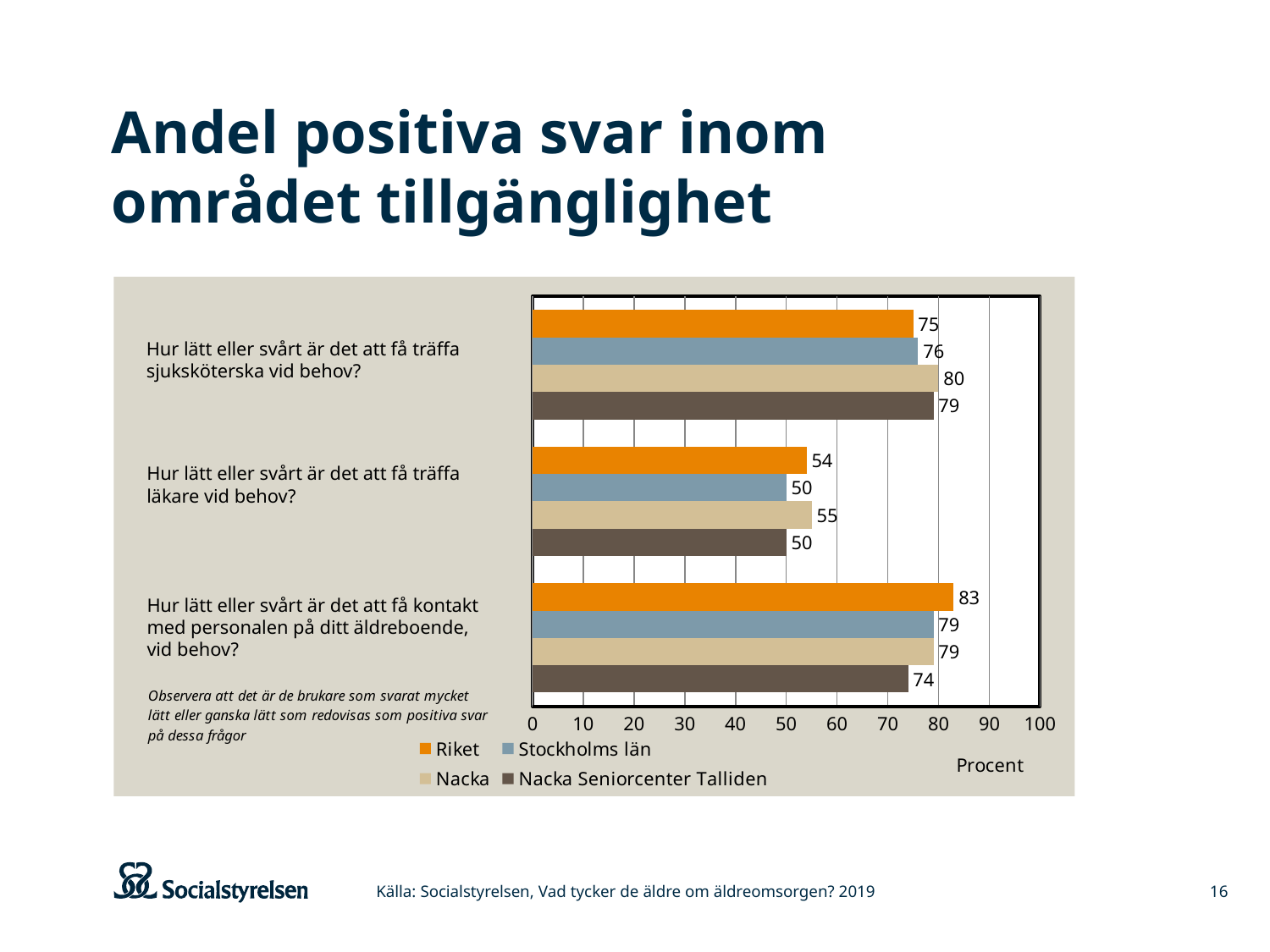
What unit is shown on the horizontal axis of the chart? Procent Is the Nacka value for the question "Hur lätt eller svårt är det att få träffa sjuksköterska vid behov?" greater or less than 70? greater How many series does the legend list? 4 Which series has the lowest value for the question "Hur lätt eller svårt är det att få träffa sjuksköterska vid behov?"? Riket What is the value for Nacka Seniorcenter Talliden on the question "Hur lätt eller svårt är det att få kontakt med personalen på ditt äldreboende, vid behov?"? 74 What is the value for Stockholms län on the question "Hur lätt eller svårt är det att få träffa läkare vid behov?"? 50 How many questions (categories) are shown on the chart? 3 Which is larger for the question "Hur lätt eller svårt är det att få träffa läkare vid behov?": the Nacka value or the Stockholms län value? Nacka What is the value for Riket on the question "Hur lätt eller svårt är det att få träffa sjuksköterska vid behov?"? 75 What is the difference between the Riket value and the Nacka Seniorcenter Talliden value for the question "Hur lätt eller svårt är det att få kontakt med personalen på ditt äldreboende, vid behov?"? 9 What kind of chart is shown on the slide? Bar chart Which series has the highest value for the question "Hur lätt eller svårt är det att få kontakt med personalen på ditt äldreboende, vid behov?"? Riket